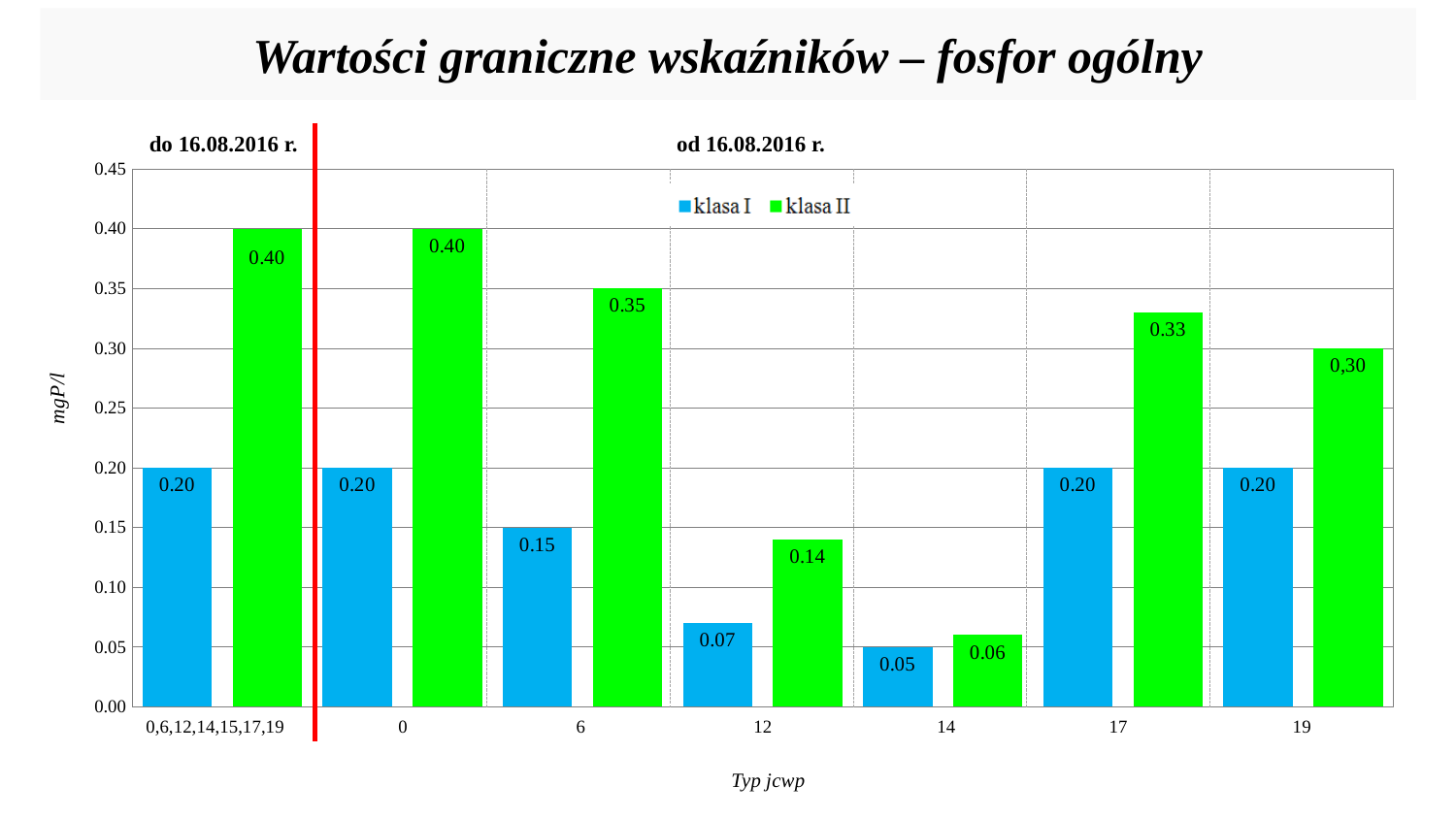
What is the difference between the klasa II and klasa I values for category 6? 0.20 Is the klasa II value for category 0 greater or less than 0.30? greater What is the value for klasa II for category 6? 0.35 Which category has the highest klasa I value among 6, 12 and 14? 6 How many series does the legend list? 2 What is the value for klasa II for category 17? 0.33 Which is larger: the klasa II value for category 17 or the klasa II value for category 19? klasa II for category 17 What is the value for klasa I for category 14? 0.05 How many categories are shown on the x axis? 7 What is the value for klasa I for category 12? 0.07 What type of chart is shown on the slide? bar chart Which category has the lowest klasa II value? 14